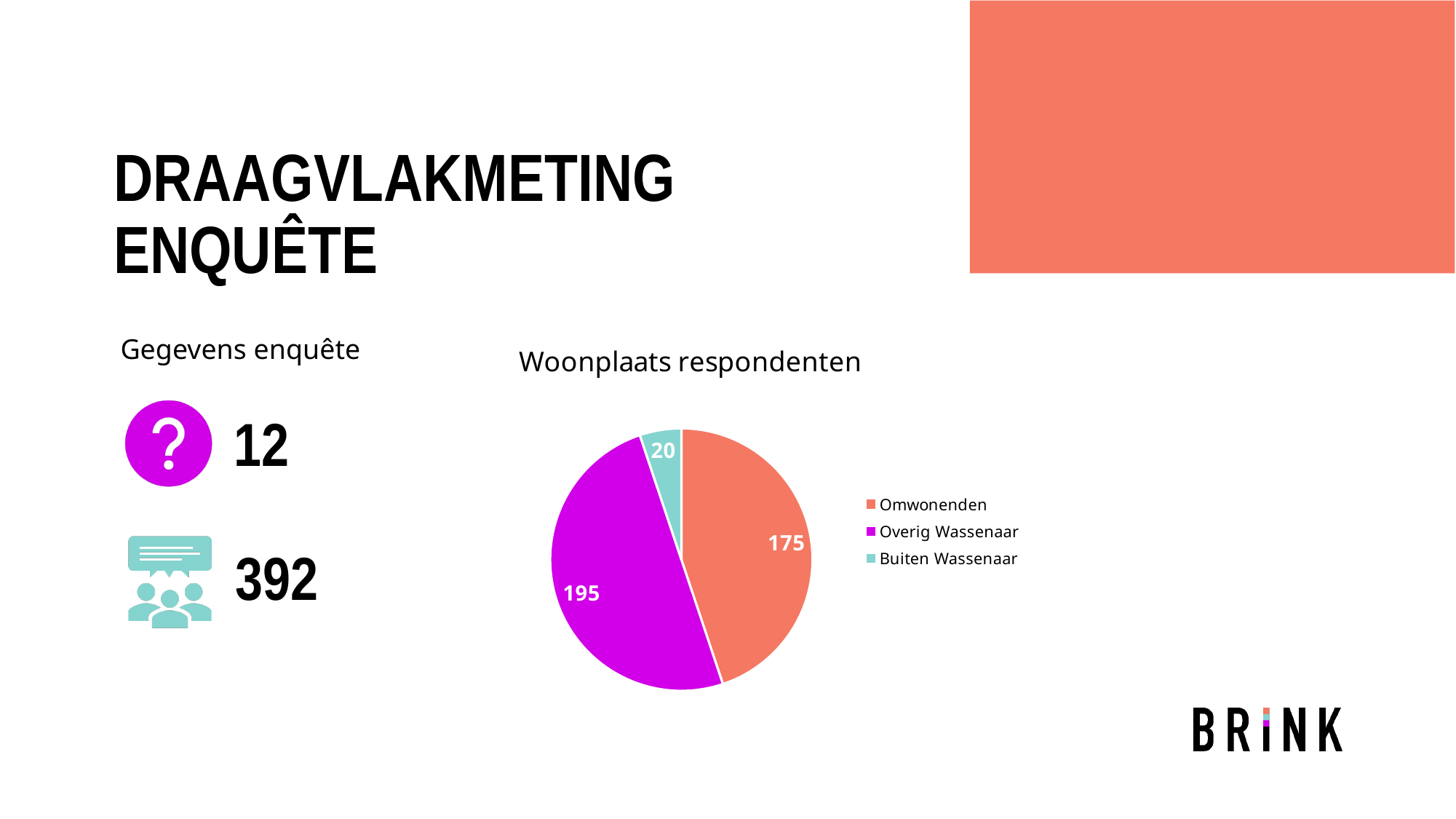
What kind of chart is shown under the heading "Woonplaats respondenten"? Pie chart In the "Woonplaats respondenten" pie chart, what is the value for Buiten Wassenaar? 20 In the "Woonplaats respondenten" pie chart, what is the difference between the values for Overig Wassenaar and Omwonenden? 20 Which category has the largest slice in the "Woonplaats respondenten" pie chart? Overig Wassenaar In the "Woonplaats respondenten" pie chart, which is larger: Omwonenden or Buiten Wassenaar? Omwonenden What colour is the Buiten Wassenaar slice in the "Woonplaats respondenten" pie chart? Teal (light blue-green) What share of the "Woonplaats respondenten" pie does Overig Wassenaar represent? 50% Which category has the smallest slice in the "Woonplaats respondenten" pie chart? Buiten Wassenaar How many categories does the "Woonplaats respondenten" pie chart show? 3 In the "Woonplaats respondenten" pie chart, what is the value for Overig Wassenaar? 195 What is the total of all slices in the "Woonplaats respondenten" pie chart? 390 In the "Woonplaats respondenten" pie chart, what is the value for Omwonenden? 175